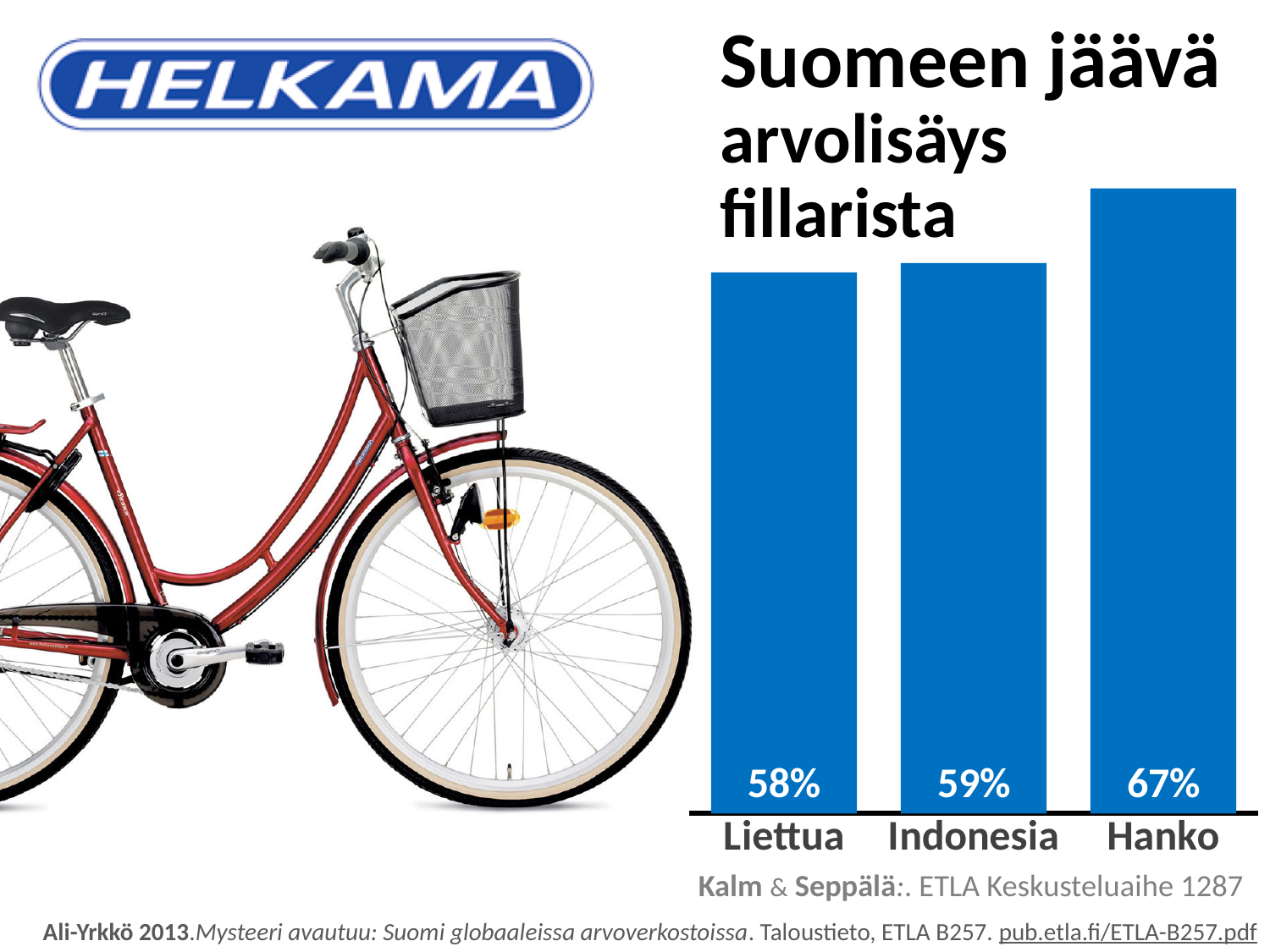
What is the difference between the values for Hanko and Liettua? 9% What is the value for Hanko? 67% Which category has the highest value? Hanko What is the value for Liettua? 58% Which is larger, the value for Hanko or the value for Indonesia? Hanko Which category has the lowest value? Liettua Do the values rise or fall from left to right across the categories? rise What kind of chart is shown on the slide? bar chart What is the difference between the values for Hanko and Indonesia? 8% How many categories are shown in the chart? 3 What is the value for Indonesia? 59% What is the title of the chart? Suomeen jäävä arvolisäys fillarista